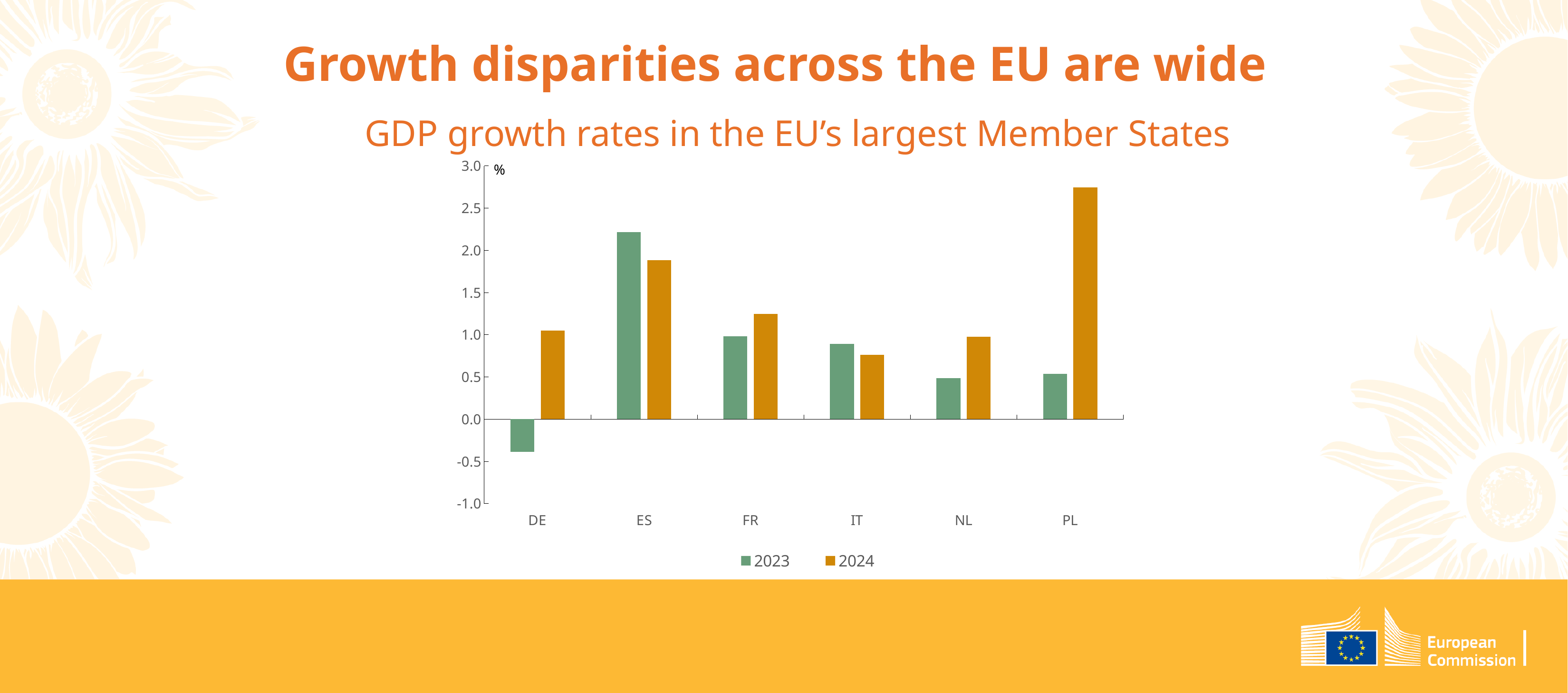
How many Member States are shown on the x axis of the chart? 6 Which Member State has the highest GDP growth rate for 2023? ES Which Member State has the lowest GDP growth rate for 2023? DE For ES, which year has the larger GDP growth rate, 2023 or 2024? 2023 Which Member State has the highest GDP growth rate for 2024? PL Is the 2023 GDP growth rate for DE greater or less than 0.0? less For FR, which year has the larger GDP growth rate, 2023 or 2024? 2024 What kind of chart is shown on the slide? Bar chart Is the 2023 GDP growth rate for ES greater or less than 2.0? greater How many series does the chart's legend list? 2 Is the 2024 GDP growth rate for PL greater or less than 2.5? greater